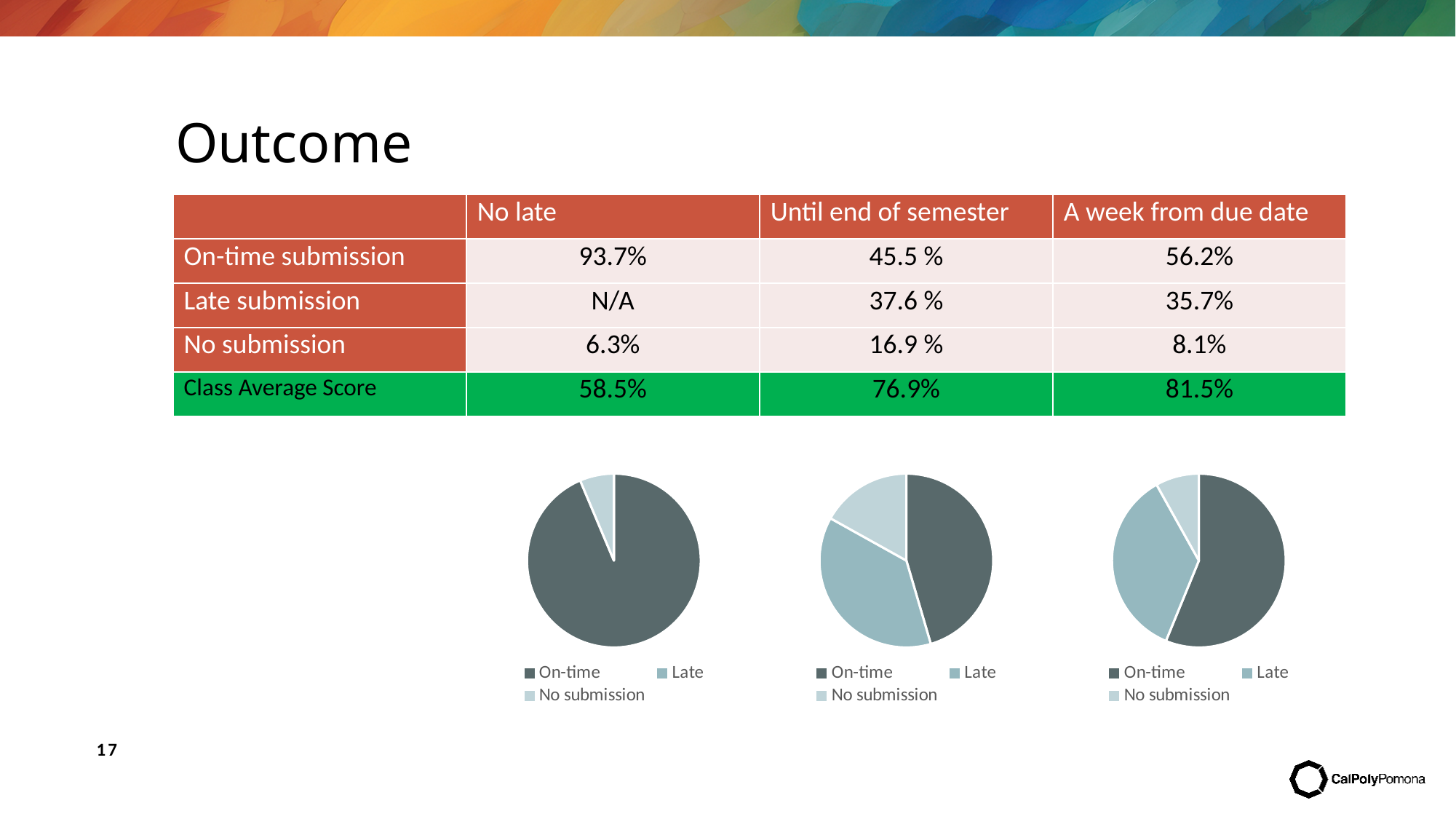
How many entries does the legend of the leftmost pie chart list? 3 In the middle pie chart, which category has the smallest slice? No submission In the leftmost pie chart, which category has the largest slice? On-time In the rightmost pie chart, which category has the largest slice? On-time How many slices does the middle pie chart have? 3 How many slices are visible in the leftmost pie chart? 2 What are the legend entries of the middle pie chart? On-time, Late, No submission In the leftmost pie chart, which category has the smallest visible slice? No submission In the rightmost pie chart, which slice is larger, On-time or Late? On-time In the middle pie chart, which category has the largest slice? On-time What kind of chart is the leftmost chart on the slide? pie chart How many pie charts are shown on the slide? 3